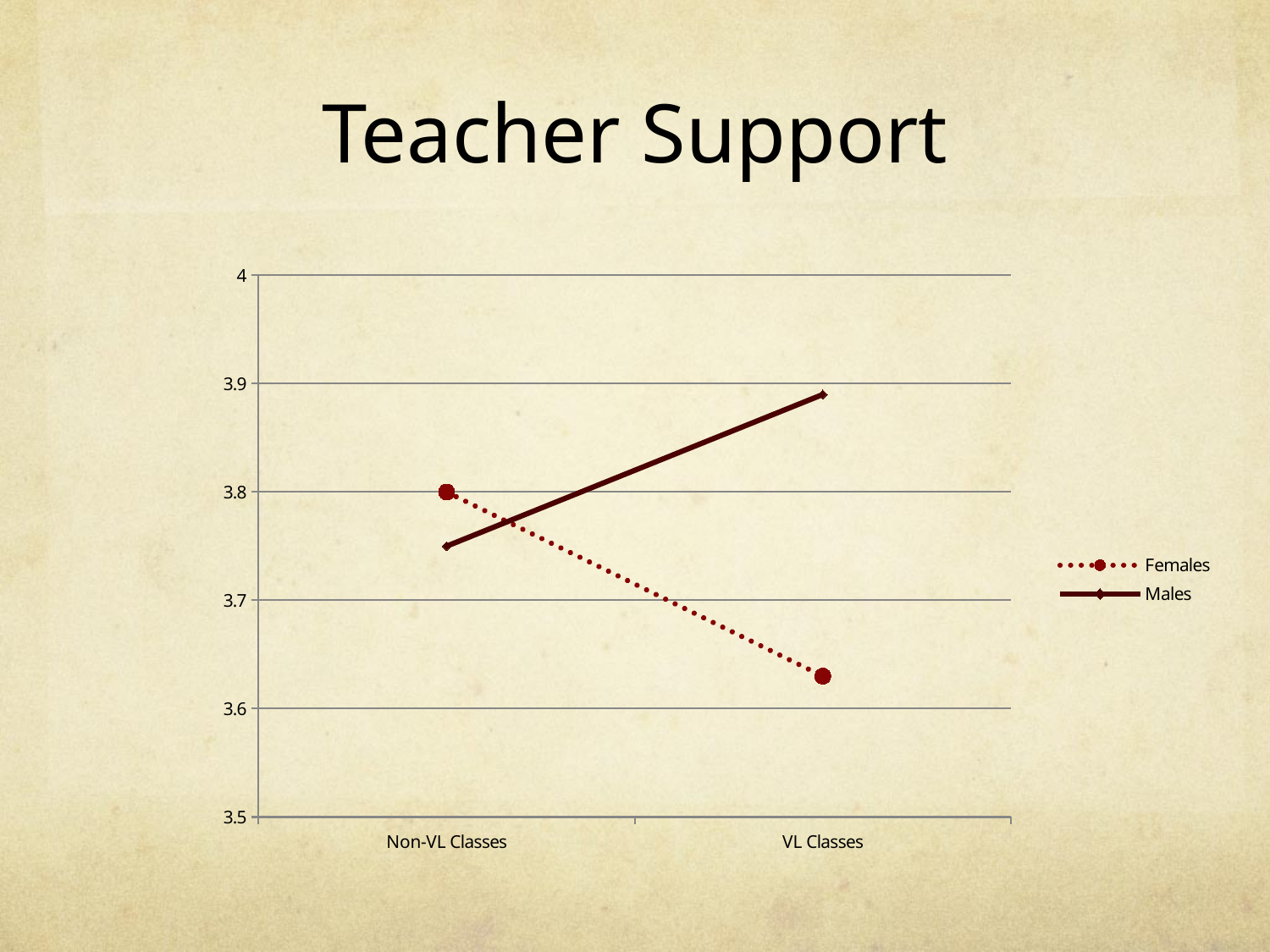
What is the title of the slide? Teacher Support What kind of chart is shown on the slide? line chart How many series does the legend list? 2 Which series has the higher value in Non-VL Classes, Females or Males? Females Do the values for Males rise or fall from Non-VL Classes to VL Classes? rise Is the value for Males in Non-VL Classes greater or less than 3.7? greater What is the value for Females in Non-VL Classes? 3.8 Is the value for Males in VL Classes greater or less than 3.8? greater Do the values for Females rise or fall from Non-VL Classes to VL Classes? fall Is the value for Females in VL Classes greater or less than 3.7? less How many categories are shown on the x axis? 2 Which series has the higher value in VL Classes, Females or Males? Males